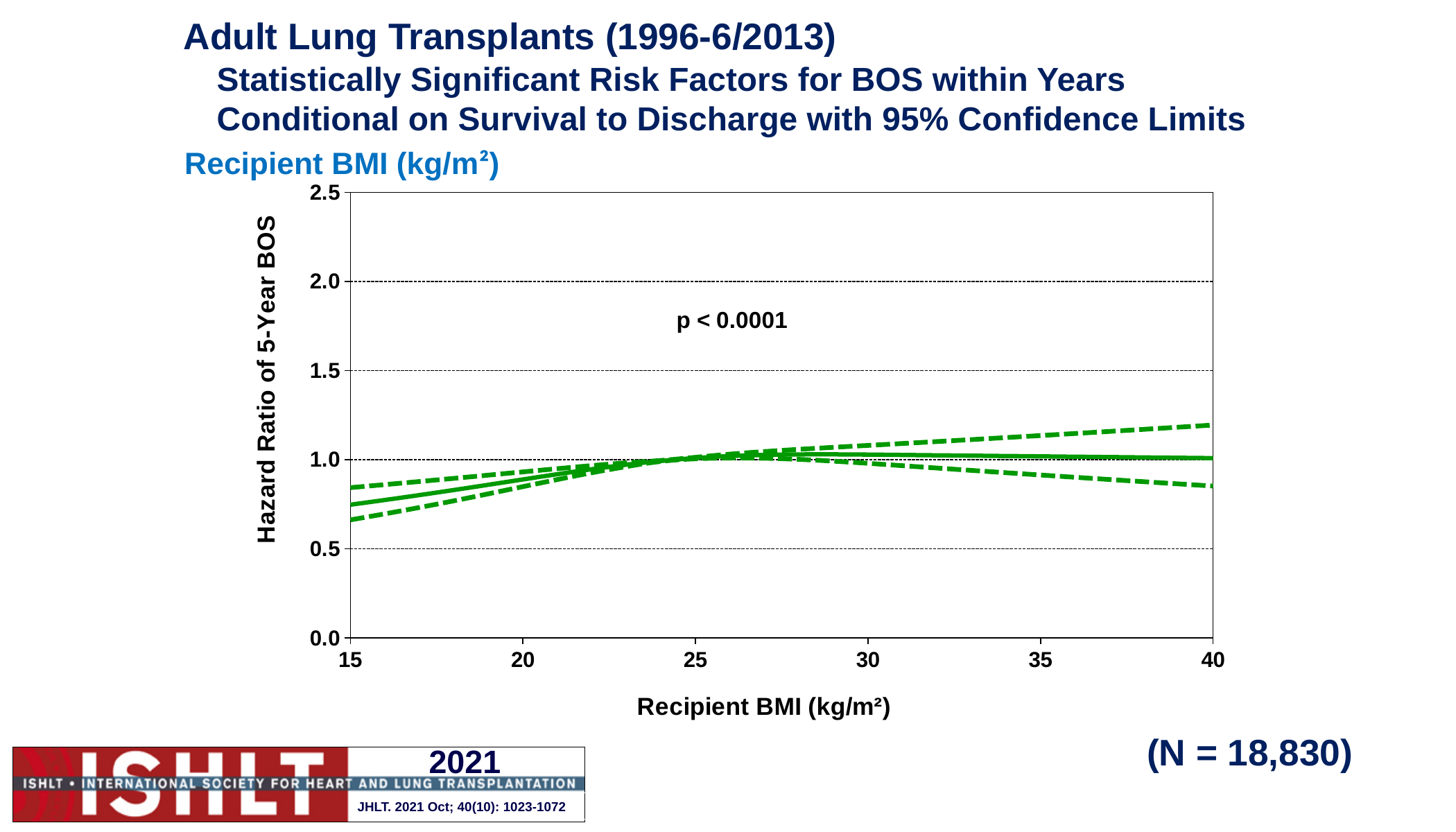
Is the upper 95% confidence limit (upper dashed line) at a recipient BMI of 40 greater or less than 1.0? greater Is the hazard ratio of 5-year BOS (solid line) at a recipient BMI of 15 greater or less than 0.5? greater Does the hazard ratio of 5-year BOS (solid line) rise or fall as recipient BMI increases from 15 to 25? rise What is the title of the chart? Recipient BMI (kg/m²) What is the label of the y-axis? Hazard Ratio of 5-Year BOS Is the hazard ratio of 5-year BOS (solid line) at a recipient BMI of 40 greater or less than 1.5? less What p-value is printed on the chart? p < 0.0001 Which is larger for the solid hazard ratio line: the value at a recipient BMI of 15 or the value at a recipient BMI of 25? 25 How many lines are plotted on the chart? 3 What kind of chart is shown on the slide? line chart